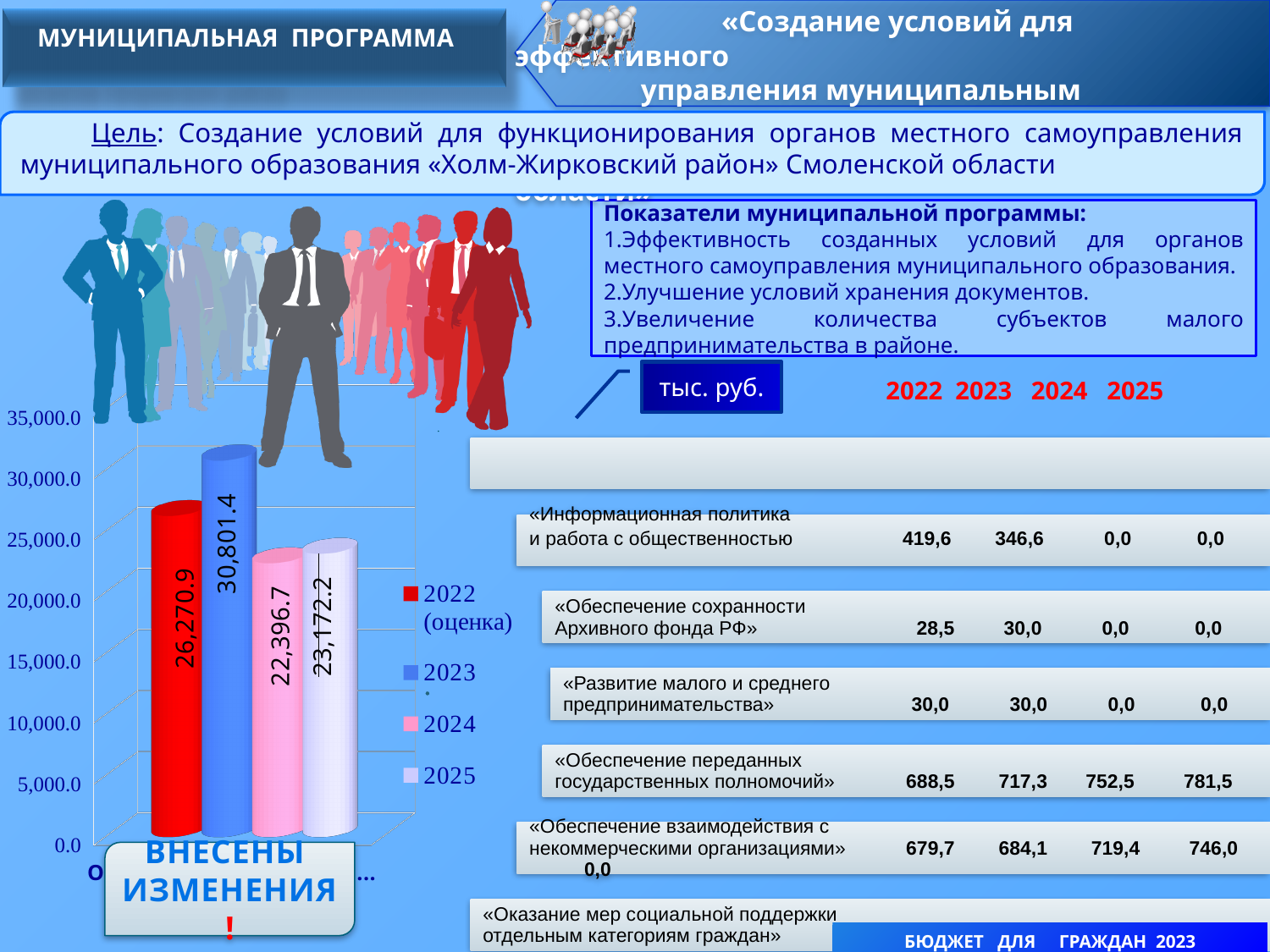
Is the value for 2023 greater or less than 30,000.0? greater Which is larger, the bar for 2025 or the bar for 2024? 2025 What is the difference between the 2023 bar and the 2022 (оценка) bar? 4,530.5 How many bars are plotted in the chart? 4 What is the value of the bar for 2022 (оценка) in the bar chart? 26,270.9 What is the value of the bar for 2023 in the bar chart? 30,801.4 What is the value of the bar for 2025 in the bar chart? 23,172.2 How many entries does the chart legend list? 4 What type of chart is shown on the left of the slide? bar chart Which year has the lowest bar in the chart? 2024 Which year has the highest bar in the chart? 2023 What is the value of the bar for 2024 in the bar chart? 22,396.7